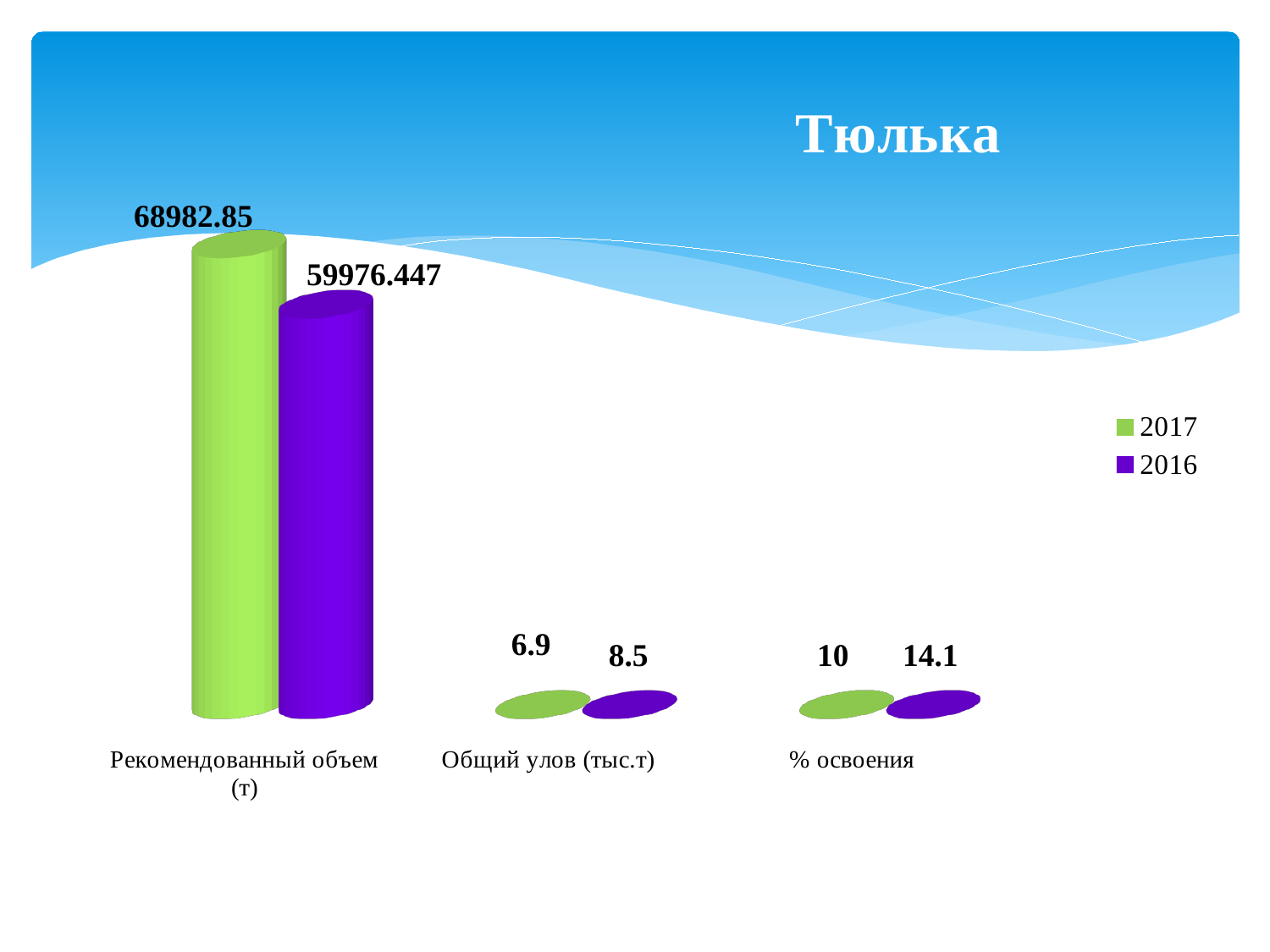
Which year has the larger value in the % освоения category, 2017 or 2016? 2016 What is the value for 2017 in the % освоения category? 10 What is the value for 2016 in the % освоения category? 14.1 What kind of chart is shown on the slide? Bar chart What is the value for 2016 in the Общий улов (тыс.т) category? 8.5 What is the value for 2016 in the Рекомендованный объем (т) category? 59976.447 What is the value for 2017 in the Общий улов (тыс.т) category? 6.9 What is the difference between the 2016 and 2017 values in the Общий улов (тыс.т) category? 1.6 How many series does the legend list? 2 What is the value for 2017 in the Рекомендованный объем (т) category? 68982.85 How many categories are shown on the x axis of the chart? 3 Which year has the larger value in the Рекомендованный объем (т) category, 2017 or 2016? 2017